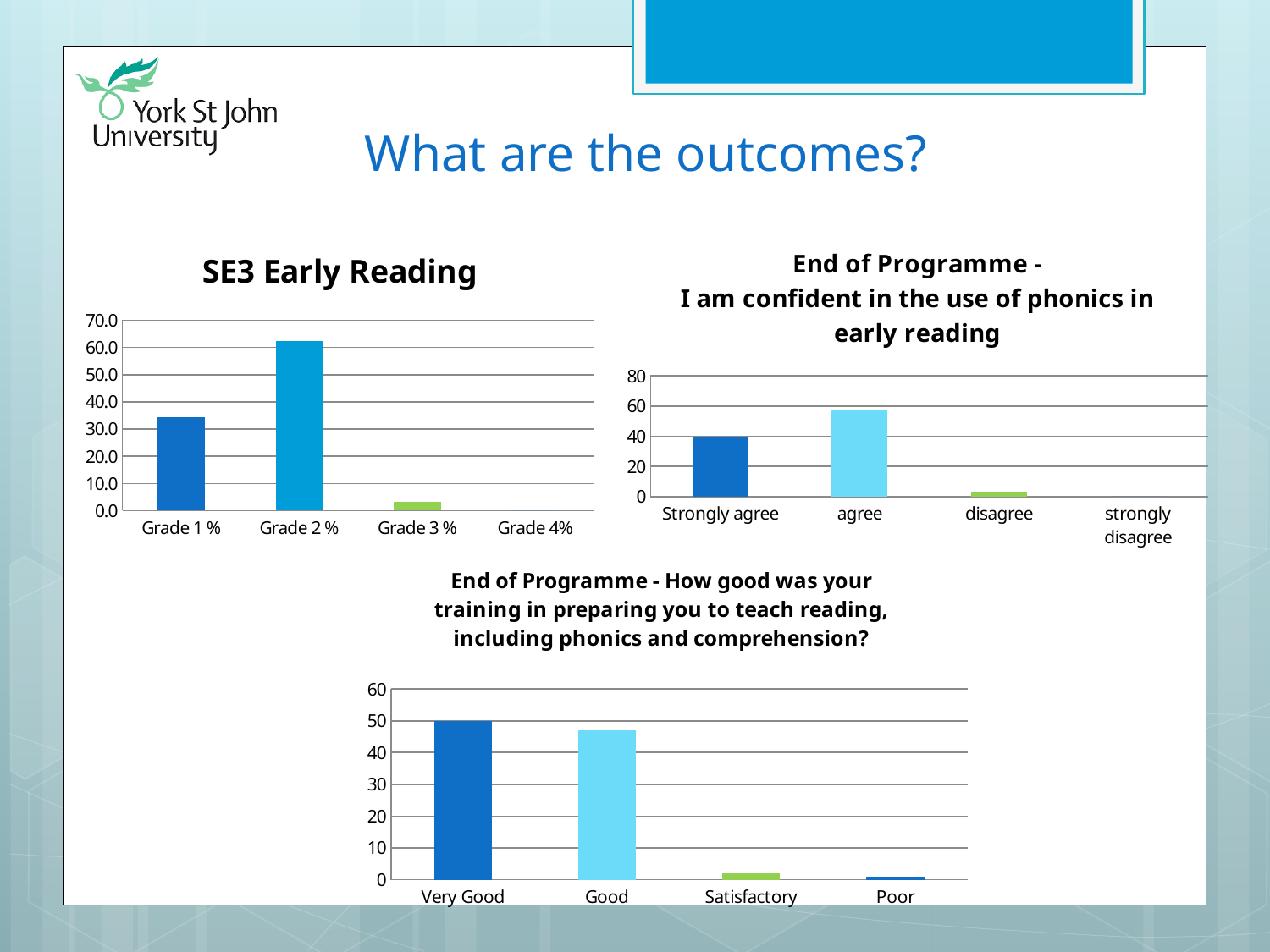
In the 'SE3 Early Reading' chart, is the value for Grade 1 % greater or less than 30.0? greater In the 'SE3 Early Reading' chart, which grade has the highest value? Grade 2 % In the 'SE3 Early Reading' chart, how many grade categories are shown on the x axis? 4 In the 'SE3 Early Reading' chart, which is larger, Grade 1 % or Grade 3 %? Grade 1 % In the 'End of Programme - How good was your training...' chart at the bottom, which response has the lowest value? Poor In the 'End of Programme - How good was your training...' chart at the bottom, is the value for Good greater or less than 40? greater In the 'End of Programme - How good was your training...' chart at the bottom, do the values rise or fall from Very Good to Poor along the x axis? fall In the 'SE3 Early Reading' chart, is the value for Grade 2 % greater or less than 50.0? greater What kind of chart is the 'End of Programme - How good was your training in preparing you to teach reading, including phonics and comprehension?' chart? bar chart In the 'End of Programme - I am confident in the use of phonics in early reading' chart, which response has the highest value? agree